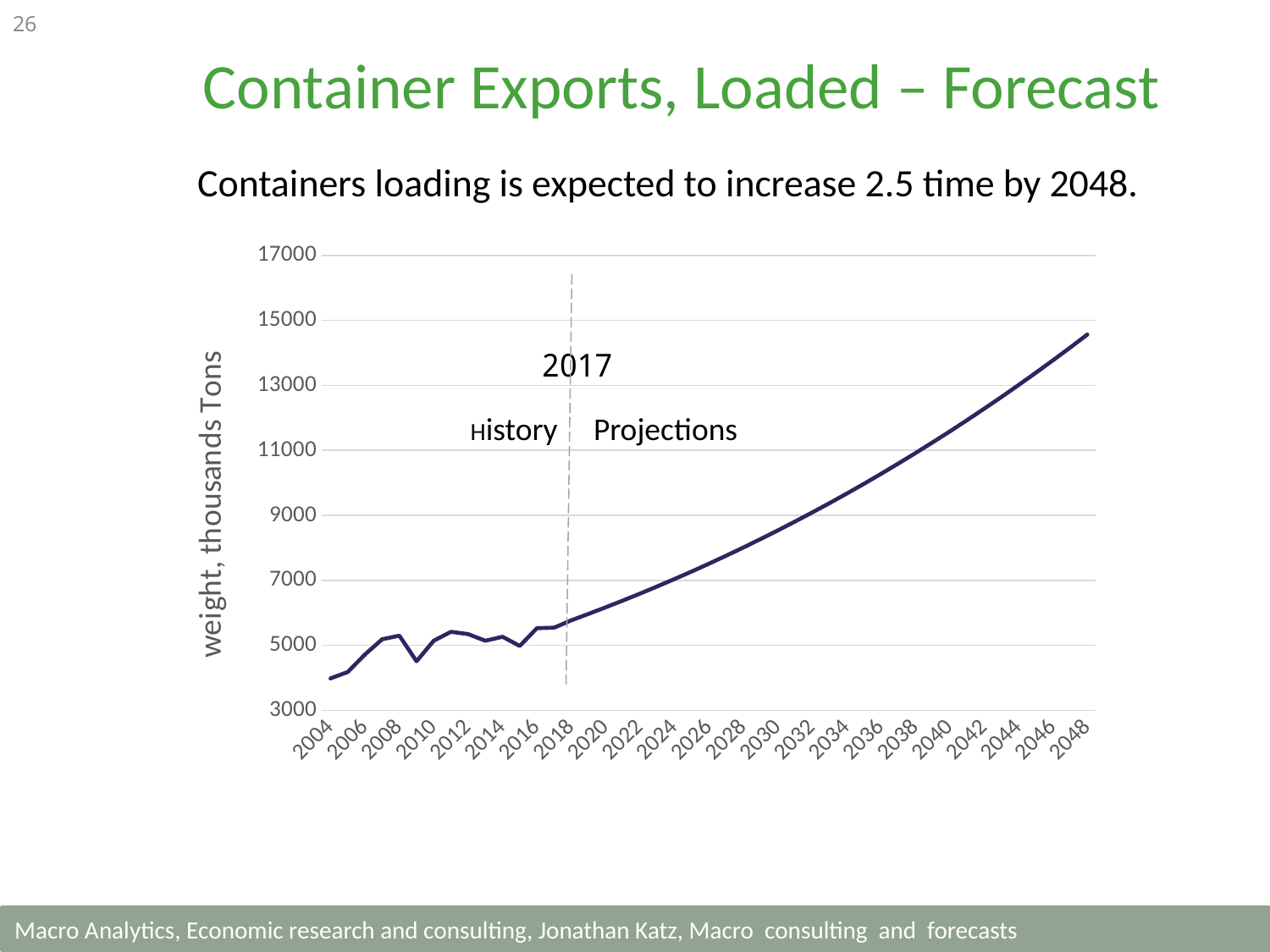
What kind of chart is shown on the slide? line chart Is the value for 2004 greater or less than 5000? less Is the value for 2030 greater or less than 9000? less Which year does the dashed vertical line separating History from Projections mark? 2017 Which year has the highest value on the chart? 2048 Is the value for 2048 greater or less than 13000? greater Do the values in the Projections section rise or fall from 2018 to 2048? rise Which year has the lowest value on the chart? 2004 What is the label on the vertical axis of the chart? weight, thousands Tons Which is larger, the value for 2036 or the value for 2024? 2036